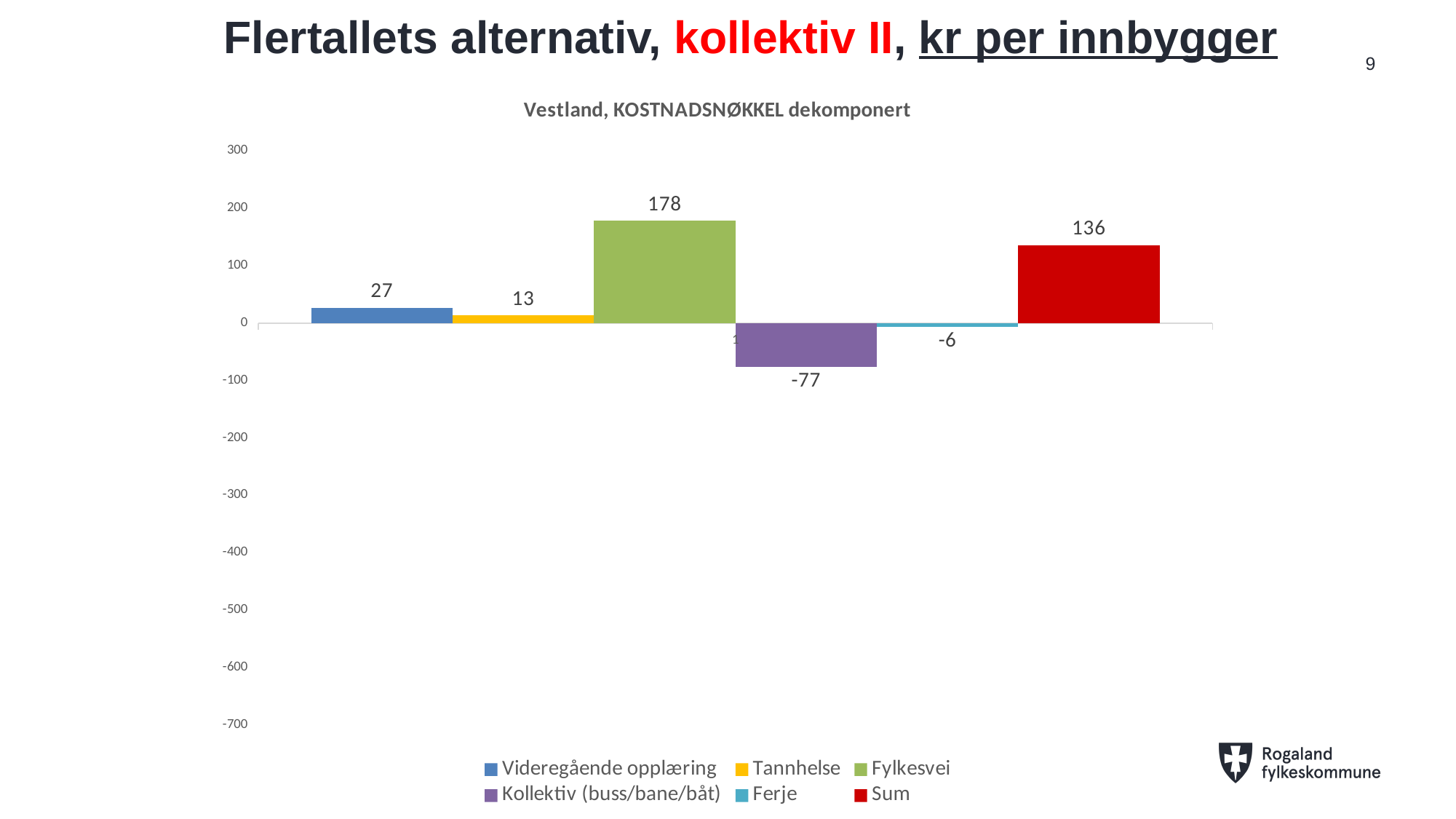
Is the value for Ferje greater or less than 0? less Which series has the lowest value? Kollektiv (buss/bane/båt) What is the value for Videregående opplæring? 27 Which is larger, the value for Videregående opplæring or the value for Tannhelse? Videregående opplæring What is the difference between the values for Fylkesvei and Sum? 42 What is the title of the chart? Vestland, KOSTNADSNØKKEL dekomponert What is the value for Sum? 136 What kind of chart is shown on the slide? Bar chart What is the value for Fylkesvei? 178 How many series does the legend list? 6 Which series has the highest value? Fylkesvei What is the value for Kollektiv (buss/bane/båt)? -77